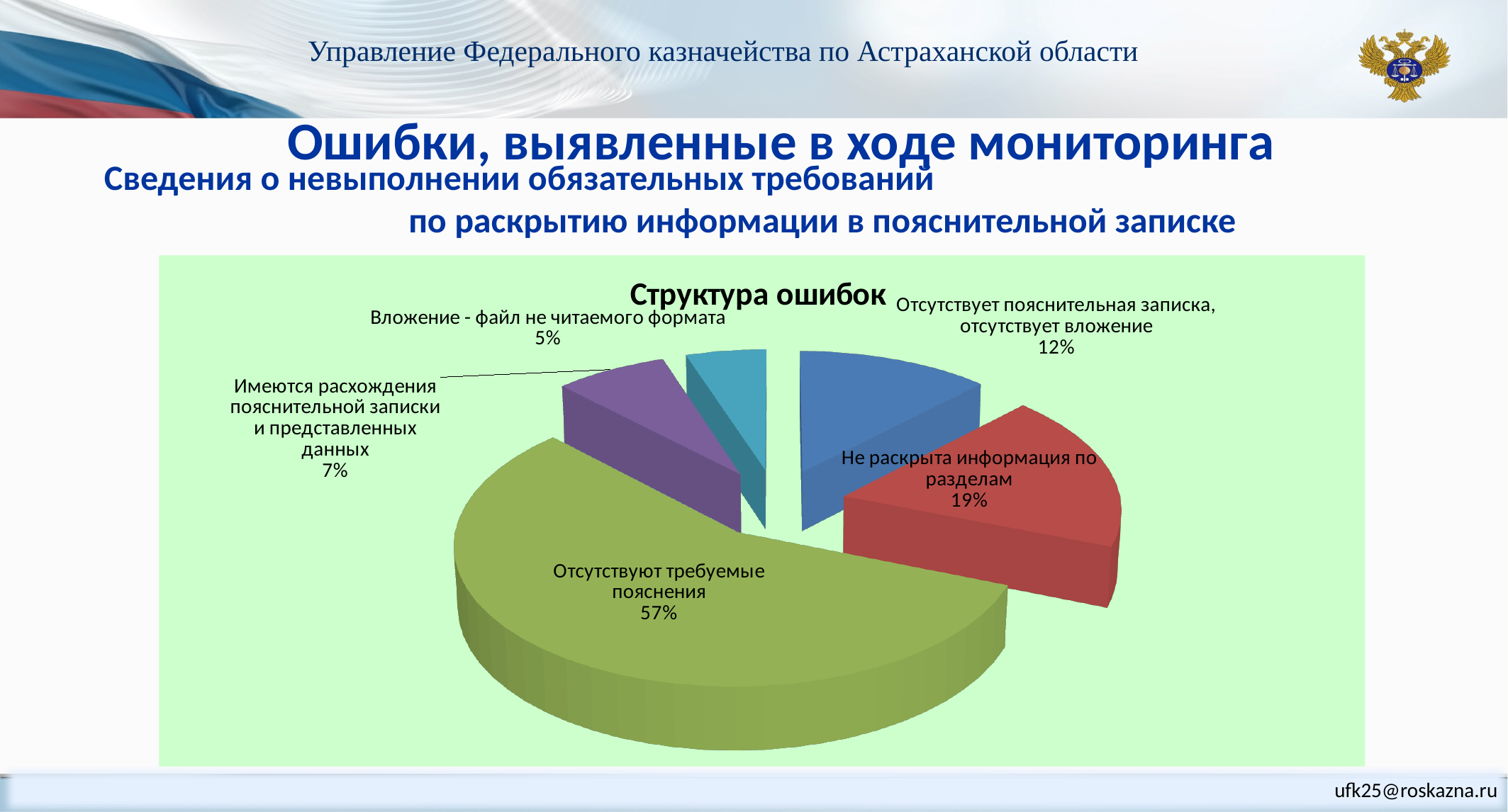
What kind of chart is shown on the slide? Pie chart Which is larger: the share for "Не раскрыта информация по разделам" or for "Отсутствует пояснительная записка, отсутствует вложение"? Не раскрыта информация по разделам Which category has the smallest share of errors? Вложение - файл не читаемого формата What is the difference in percentage points between "Отсутствуют требуемые пояснения" and "Не раскрыта информация по разделам"? 38 percentage points What share of errors is "Имеются расхождения пояснительной записки и представленных данных"? 7% Which category has the largest share of errors? Отсутствуют требуемые пояснения What share of errors is "Отсутствуют требуемые пояснения"? 57% What share of errors is "Вложение - файл не читаемого формата"? 5% How many slices does the pie chart have? 5 What is the title of the chart? Структура ошибок